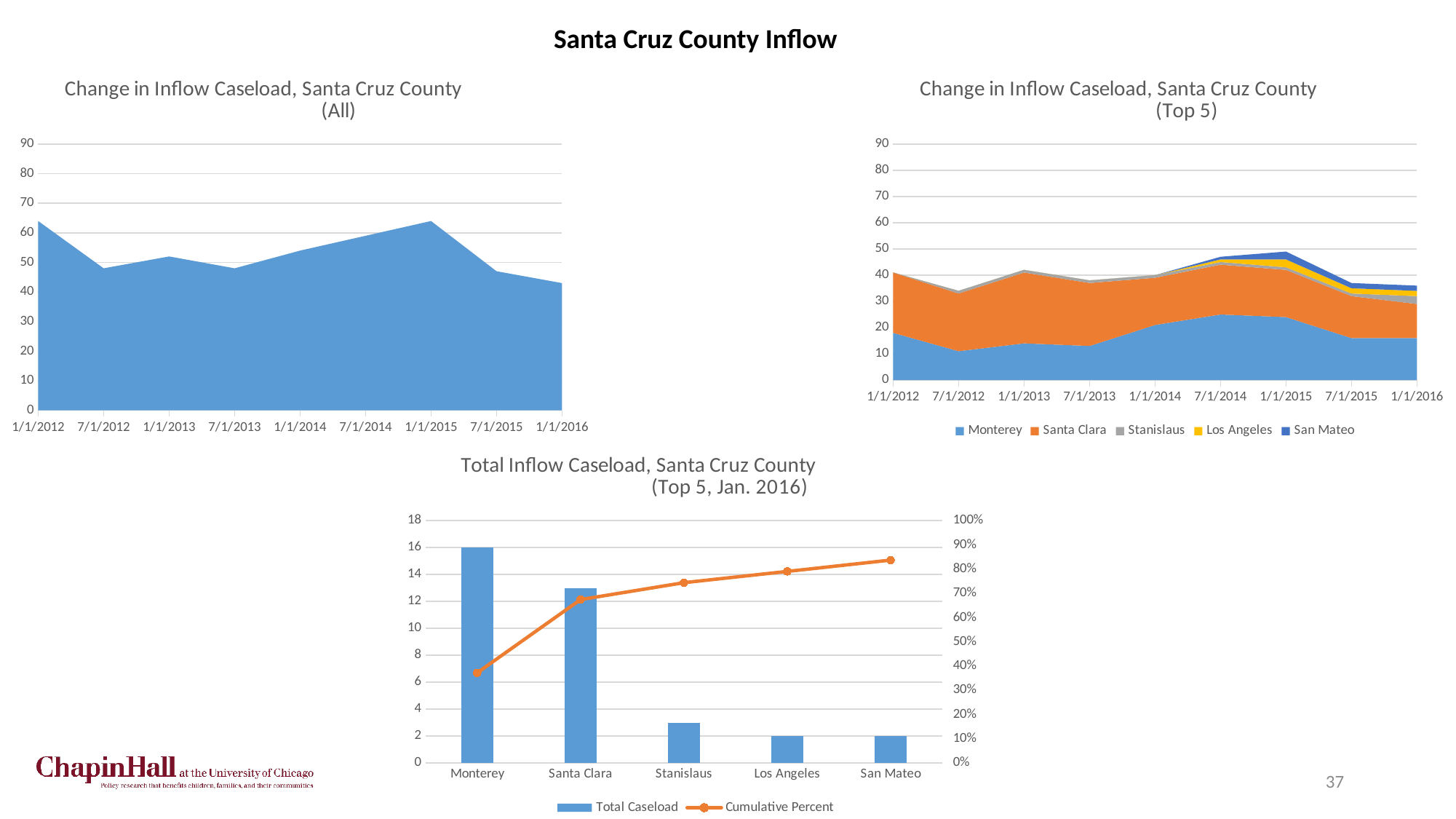
In the 'Total Inflow Caseload, Santa Cruz County (Top 5, Jan. 2016)' chart, which is larger, the Total Caseload for Santa Clara or for Stanislaus? Santa Clara In the 'Total Inflow Caseload, Santa Cruz County (Top 5, Jan. 2016)' chart, is the Total Caseload for Santa Clara greater or less than 12? greater In the 'Change in Inflow Caseload, Santa Cruz County (All)' chart, is the value at 1/1/2015 greater or less than 60? greater In the 'Change in Inflow Caseload, Santa Cruz County (Top 5)' chart, which series is shown in orange? Santa Clara In the 'Change in Inflow Caseload, Santa Cruz County (All)' chart, how many dates are shown on the x axis? 9 In the 'Total Inflow Caseload, Santa Cruz County (Top 5, Jan. 2016)' chart, is the Cumulative Percent for Monterey greater or less than 50%? less How many series does the legend of the 'Change in Inflow Caseload, Santa Cruz County (Top 5)' chart list? 5 In the 'Total Inflow Caseload, Santa Cruz County (Top 5, Jan. 2016)' chart, how many counties are shown on the x axis? 5 In the 'Total Inflow Caseload, Santa Cruz County (Top 5, Jan. 2016)' chart, which county has the highest Total Caseload? Monterey In the 'Total Inflow Caseload, Santa Cruz County (Top 5, Jan. 2016)' chart, what is the Total Caseload for San Mateo? 2 In the 'Total Inflow Caseload, Santa Cruz County (Top 5, Jan. 2016)' chart, what is the Total Caseload for Monterey? 16